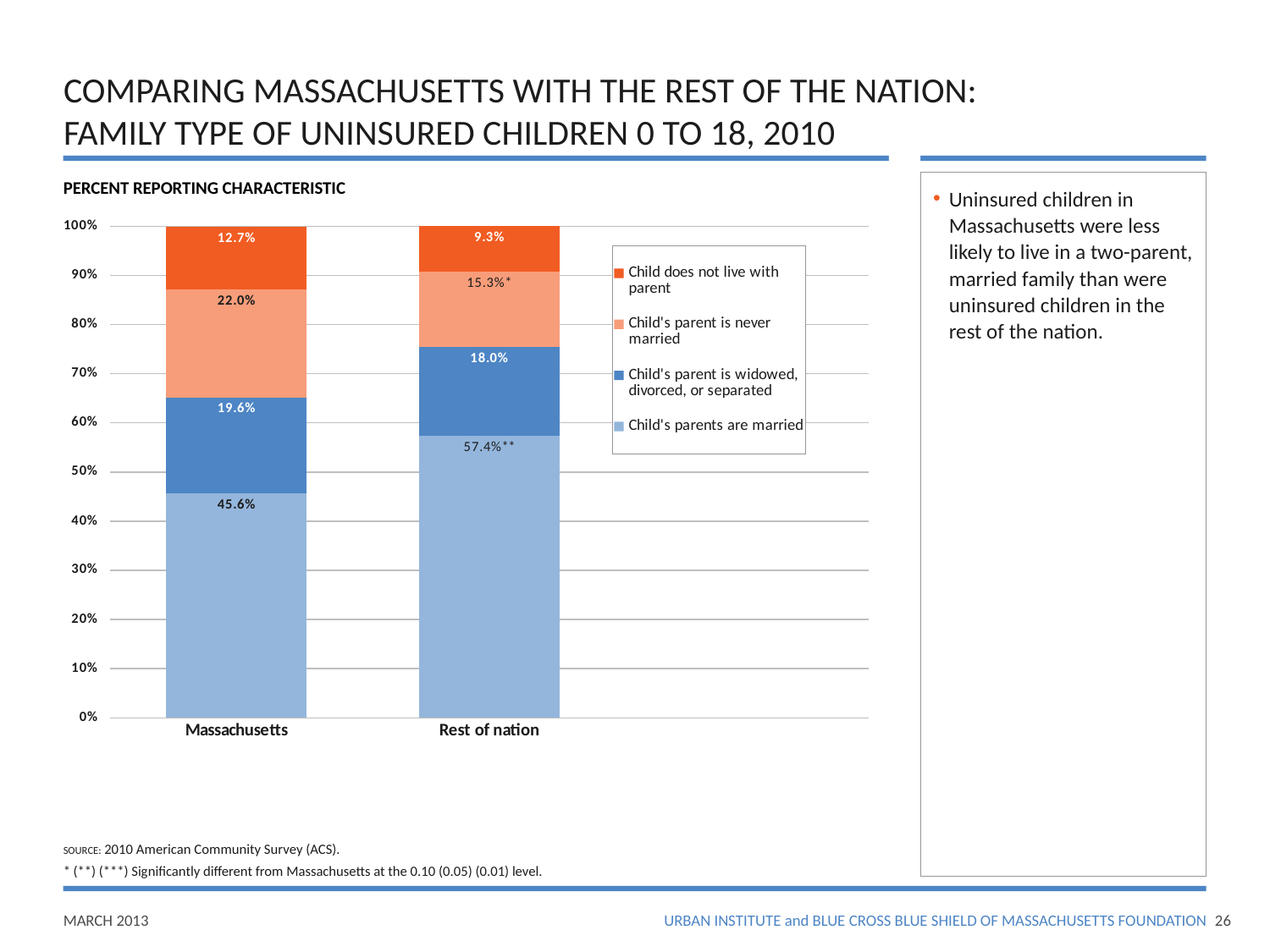
What is the difference between Massachusetts and the rest of the nation for 'Child's parent is never married'? 6.7 percentage points How many categories are shown on the x axis? 2 How many series does the legend list? 4 What is the value for 'Child's parent is never married' for Massachusetts? 22.0% What percentage of uninsured children in the rest of the nation have parents who are married? 57.4% What percentage of uninsured children in Massachusetts have parents who are married? 45.6% Which family type segment is the smallest for Massachusetts? Child does not live with parent Which has the larger share of uninsured children whose parents are married, Massachusetts or the rest of the nation? Rest of nation What type of chart is shown on the slide? Stacked bar chart How many percentage points higher is the 'Child's parents are married' share for the rest of the nation than for Massachusetts? 11.8 percentage points What is the value for 'Child's parent is widowed, divorced, or separated' for the rest of the nation? 18.0% What is the value for 'Child does not live with parent' for the rest of the nation? 9.3%